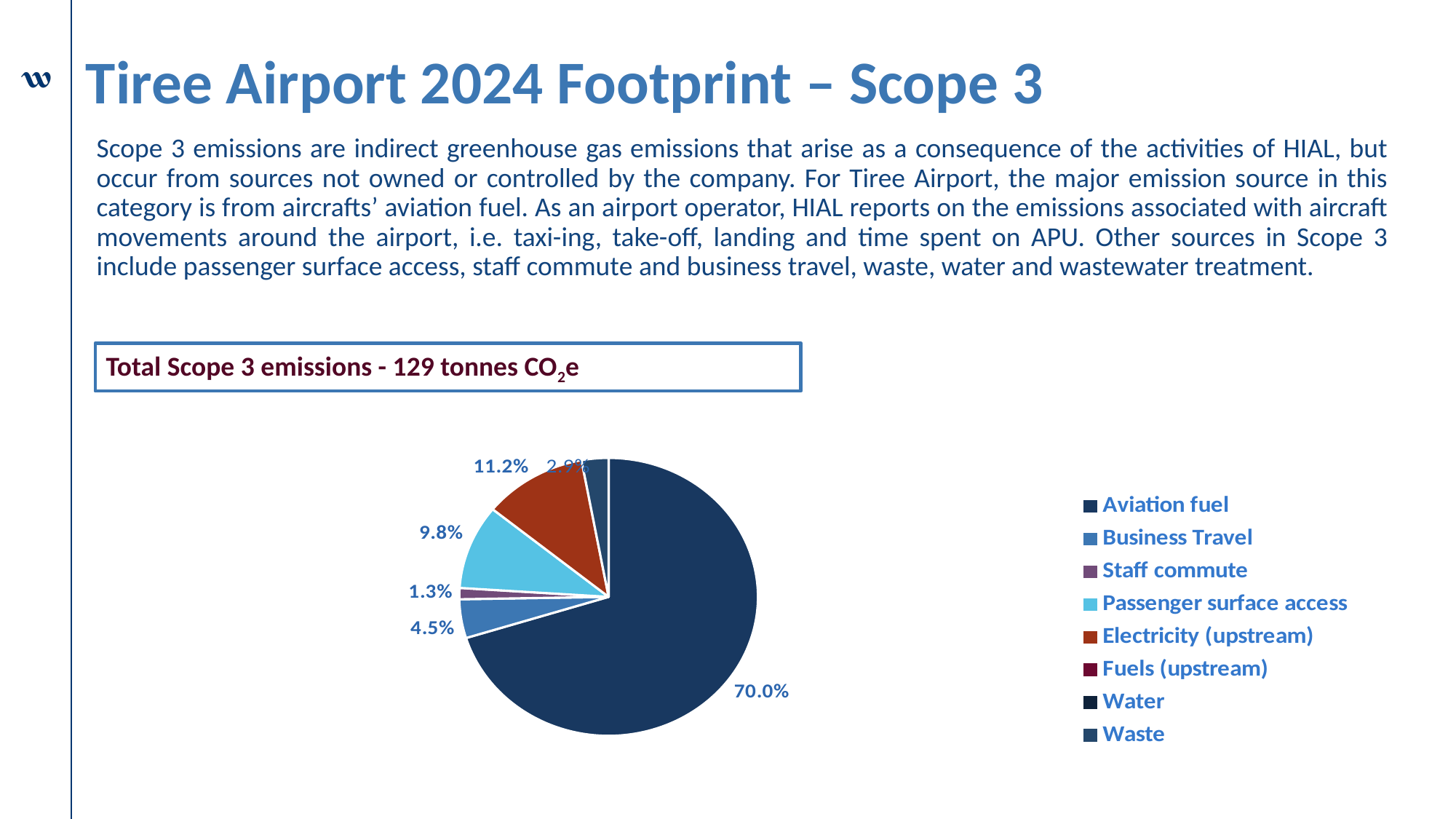
What share of Scope 3 emissions comes from Electricity (upstream)? 11.2% Which category accounts for the largest share of Scope 3 emissions? Aviation fuel Which has the larger share: Business Travel or Staff commute? Business Travel What share of Scope 3 emissions comes from Business Travel? 4.5% What total Scope 3 emissions figure is stated above the chart? 129 tonnes CO2e What share of Scope 3 emissions comes from Staff commute? 1.3% Which has the larger share: Electricity (upstream) or Passenger surface access? Electricity (upstream) What type of chart is shown on the slide? Pie chart What is the difference in percentage points between the Aviation fuel share and the Electricity (upstream) share? 58.8 percentage points How many categories does the legend of the pie chart list? 8 What share of Scope 3 emissions comes from Aviation fuel? 70.0% What share of Scope 3 emissions comes from Passenger surface access? 9.8%